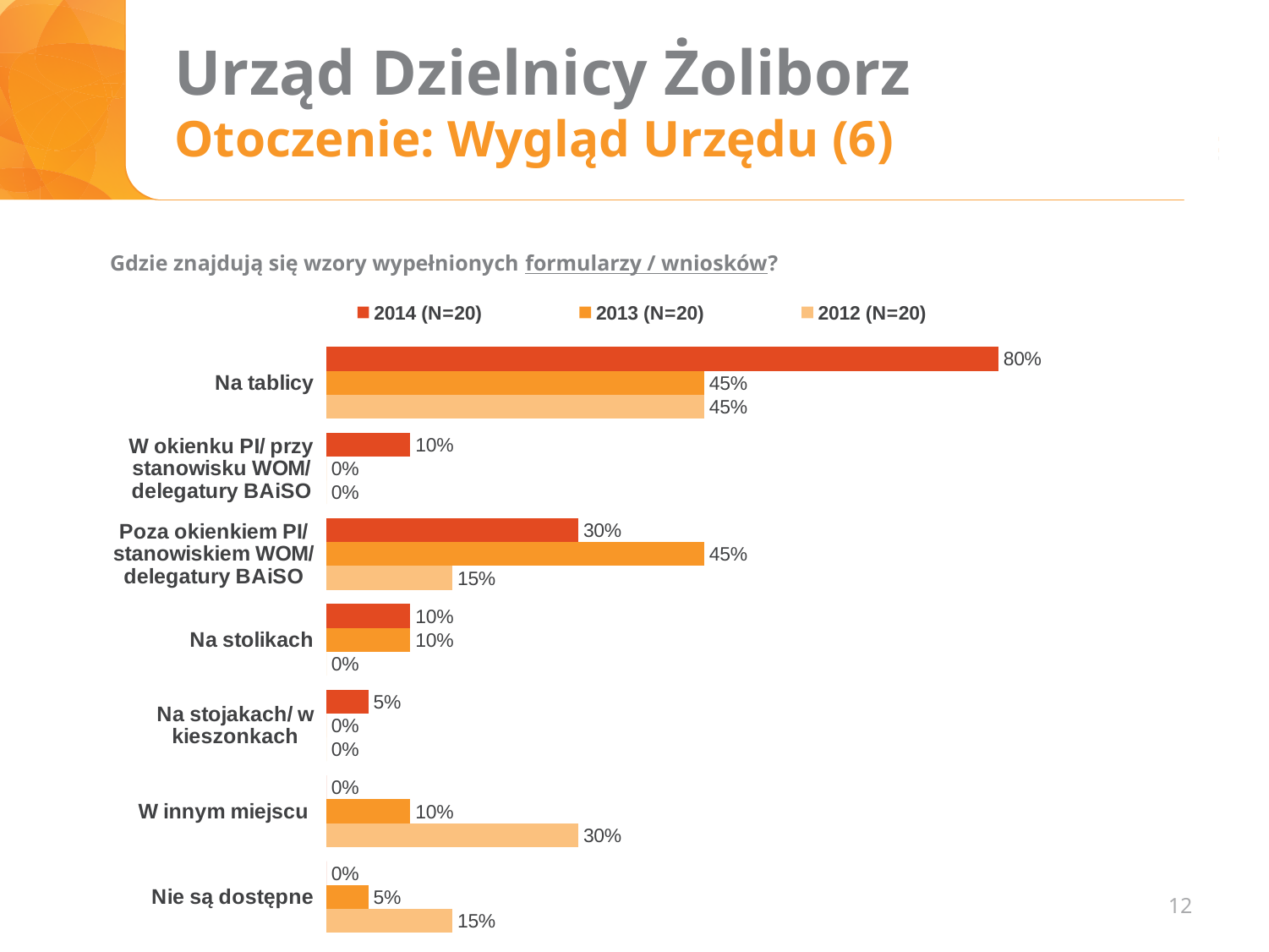
What question is the chart about, as stated above it? Gdzie znajdują się wzory wypełnionych formularzy / wniosków? How many series does the legend list? 3 For "Poza okienkiem PI/ stanowiskiem WOM/ delegatury BAiSO", which series has the larger value: 2014 (N=20) or 2012 (N=20)? 2014 (N=20) What is the value for "W innym miejscu" in the 2012 (N=20) series? 30% What is the value for "Poza okienkiem PI/ stanowiskiem WOM/ delegatury BAiSO" in the 2013 (N=20) series? 45% What is the value for "Na tablicy" in the 2014 (N=20) series? 80% Which category has the highest value in the 2014 (N=20) series? Na tablicy How many categories are shown on the chart? 7 What is the difference between the 2014 (N=20) and 2013 (N=20) values for "Na tablicy"? 35% What kind of chart is shown on the slide? Bar chart Which category has the highest value in the 2012 (N=20) series? Na tablicy What is the value for "Nie są dostępne" in the 2012 (N=20) series? 15%